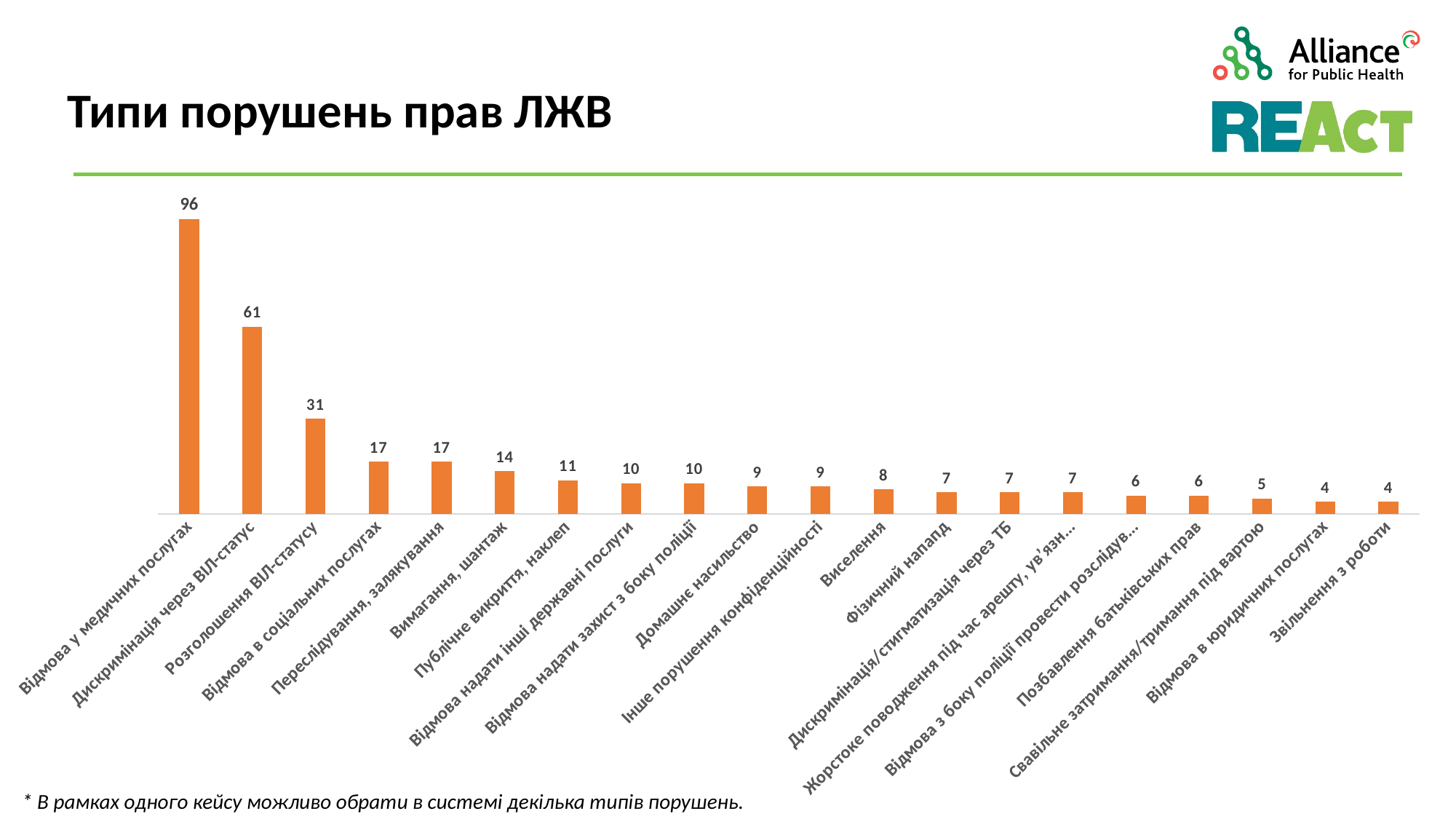
What is the value for Свавільне затримання/тримання під вартою? 5 What is the value for Вимагання, шантаж? 14 Which category has the highest value? Відмова у медичних послугах What is the value for Відмова у медичних послугах? 96 What is the value for Розголошення ВІЛ-статусу? 31 What kind of chart is shown on the slide? Bar chart What is the difference between the values for Відмова у медичних послугах and Дискримінація через ВІЛ-статус? 35 What is the value for Дискримінація через ВІЛ-статус? 61 What is the title of the chart? Типи порушень прав ЛЖВ How many categories are shown in the chart? 20 What is the value for Виселення? 8 Which is larger: the value for Публічне викриття, наклеп or the value for Домашнє насильство? Публічне викриття, наклеп